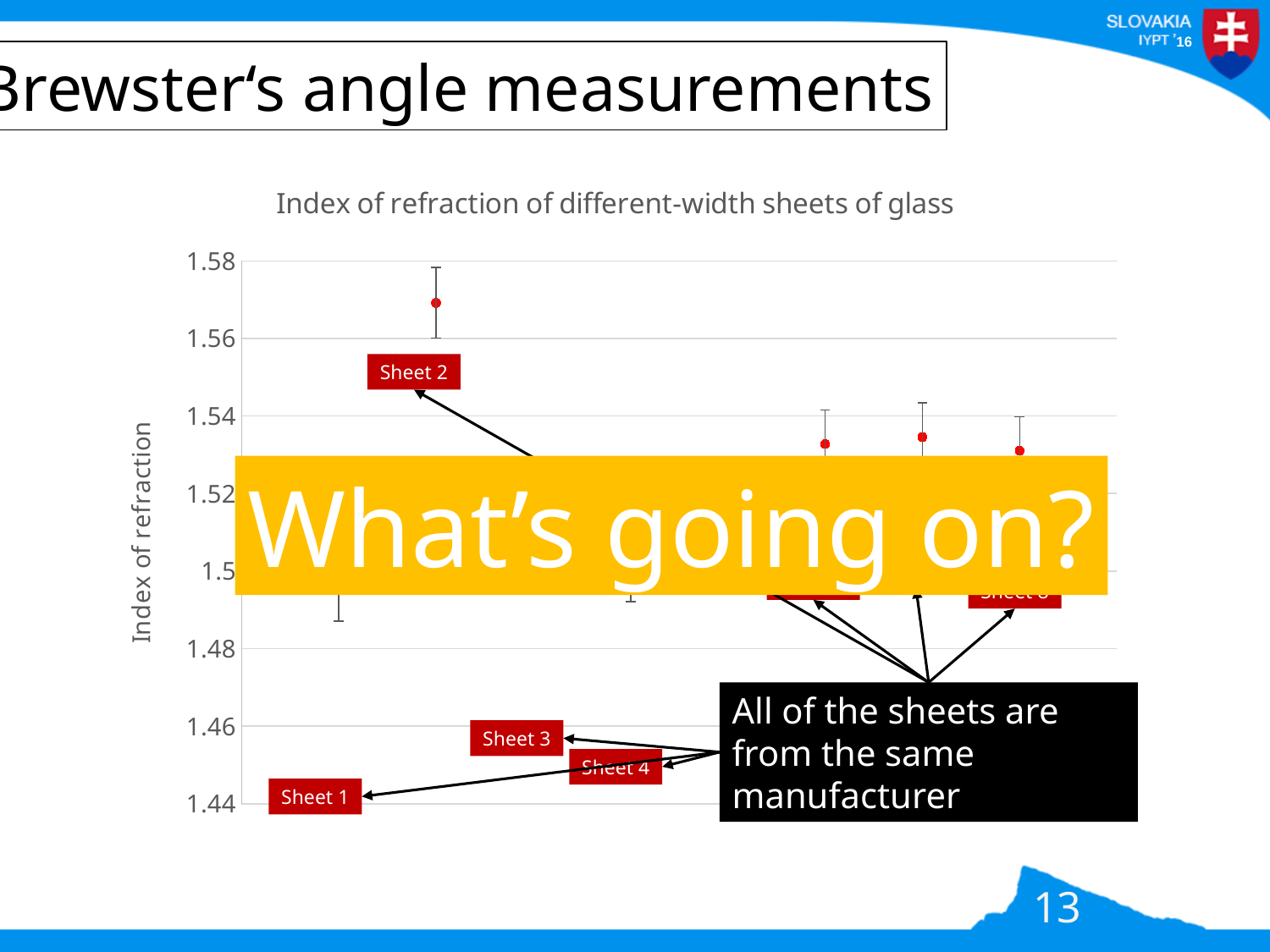
Is the value for Sheet 2 greater or less than 1.58? less What is the label of the vertical axis? Index of refraction What is the lowest value shown on the vertical axis? 1.44 What is the title of the chart? Index of refraction of different-width sheets of glass What kind of chart is shown on the slide? scatter chart Is the value for Sheet 2 greater or less than 1.56? greater Which sheet has the highest index of refraction? Sheet 2 Is the value for Sheet 2 greater or less than 1.54? greater